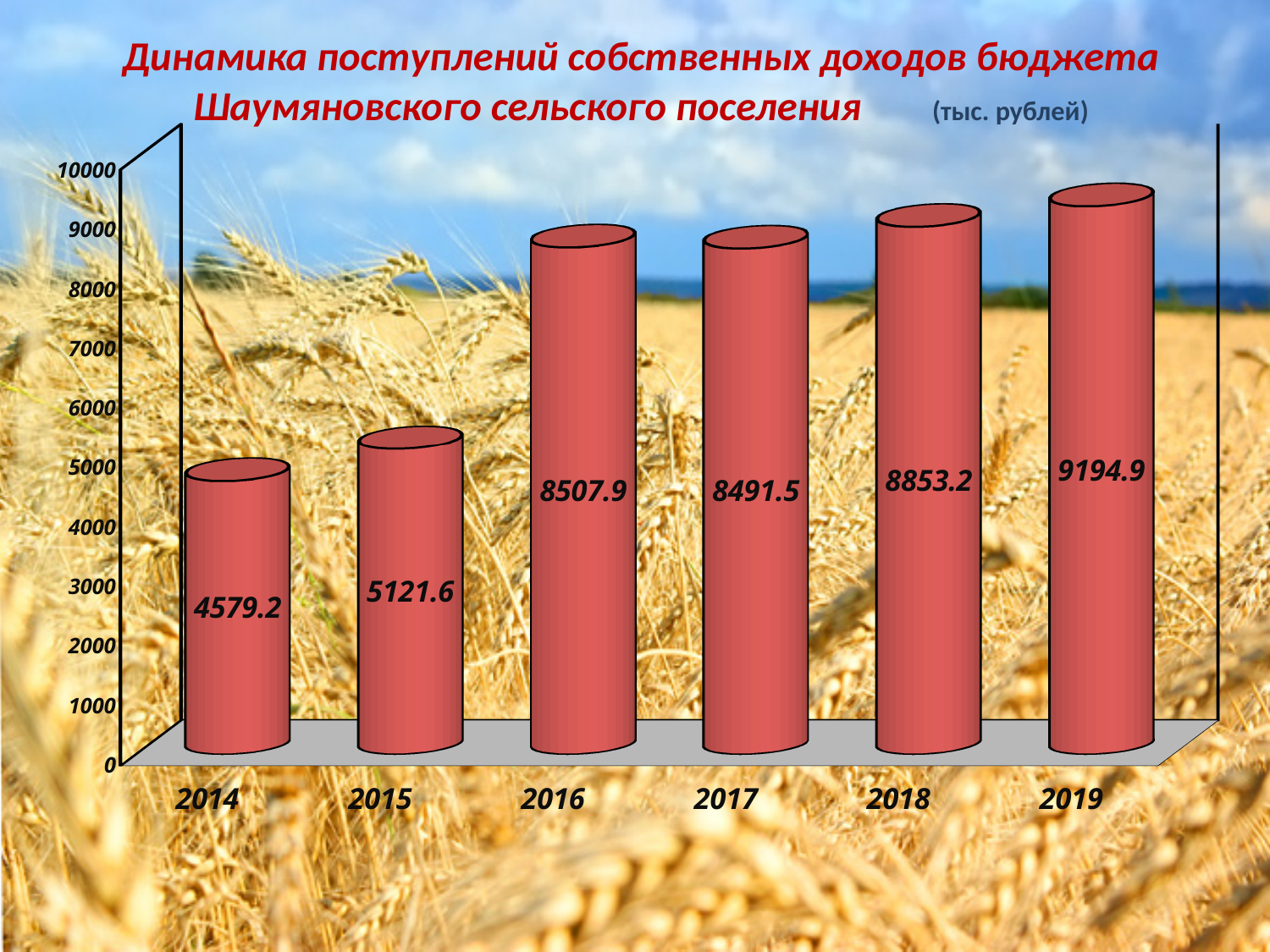
How many years are shown on the x axis? 6 Which year has the highest value? 2019 Which year has the lowest value? 2014 Which is larger, the value for 2016 or the value for 2017? 2016 What is the value for 2014? 4579.2 What is the value for 2017? 8491.5 What is the value for 2019? 9194.9 What is the difference between the values for 2015 and 2014? 542.4 What unit is given in parentheses next to the chart title? тыс. рублей Is the value for 2015 greater or less than 6000? less What is the difference between the values for 2019 and 2018? 341.7 What kind of chart is this? bar chart